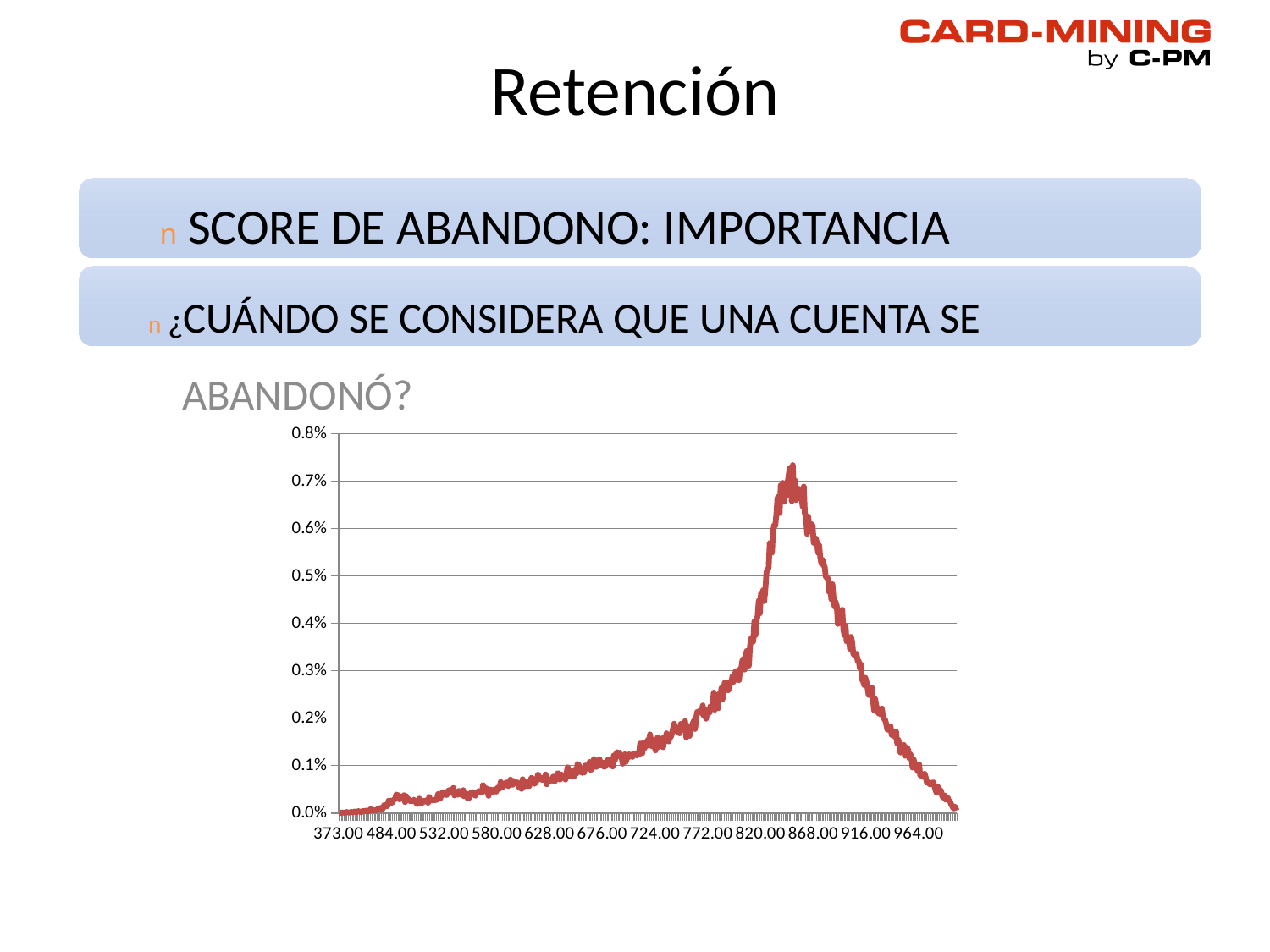
Is the value of the line at 580.00 greater or less than 0.1%? less Is the value of the line at 373.00 greater or less than 0.1%? less How many tick labels are printed along the horizontal axis of the chart? 12 Between 868.00 and 964.00, does the line rise or fall? fall Is the value of the line at 868.00 larger or smaller than the value at 484.00? larger What kind of chart is shown on the slide? line chart Is the value of the line at 820.00 greater or less than 0.2%? greater What is the highest value shown on the vertical axis of the chart? 0.8% What is the first label shown on the horizontal axis of the chart? 373.00 Between 373.00 and 820.00, does the line generally rise or fall? rise